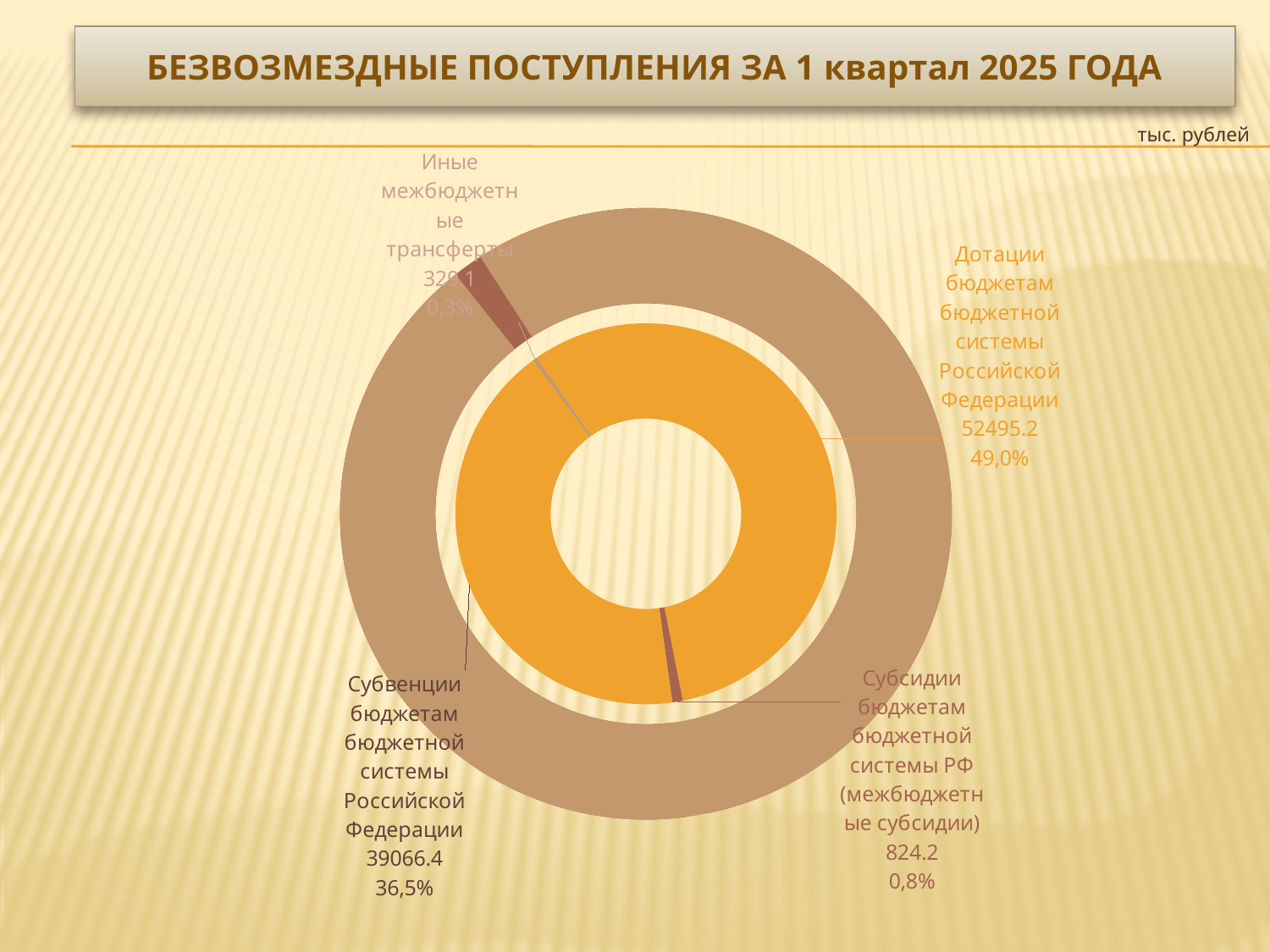
Which category has the lowest value? Иные межбюджетные трансферты What is the value for Дотации бюджетам бюджетной системы Российской Федерации? 52495.2 How many categories are shown in the chart? 4 What share of the chart does Субвенции бюджетам бюджетной системы Российской Федерации represent? 36,5% What is the value for Субвенции бюджетам бюджетной системы Российской Федерации? 39066.4 What is the value for Иные межбюджетные трансферты? 329.1 What is the difference between the values for Дотации and Субвенции? 13428.8 What share of the chart does Дотации бюджетам бюджетной системы Российской Федерации represent? 49,0% What is the value for Субсидии бюджетам бюджетной системы РФ (межбюджетные субсидии)? 824.2 Which category has the highest value? Дотации бюджетам бюджетной системы Российской Федерации Which is larger: the value for Субсидии (межбюджетные субсидии) or the value for Иные межбюджетные трансферты? Субсидии (межбюджетные субсидии) What kind of chart is shown on the slide? Doughnut chart